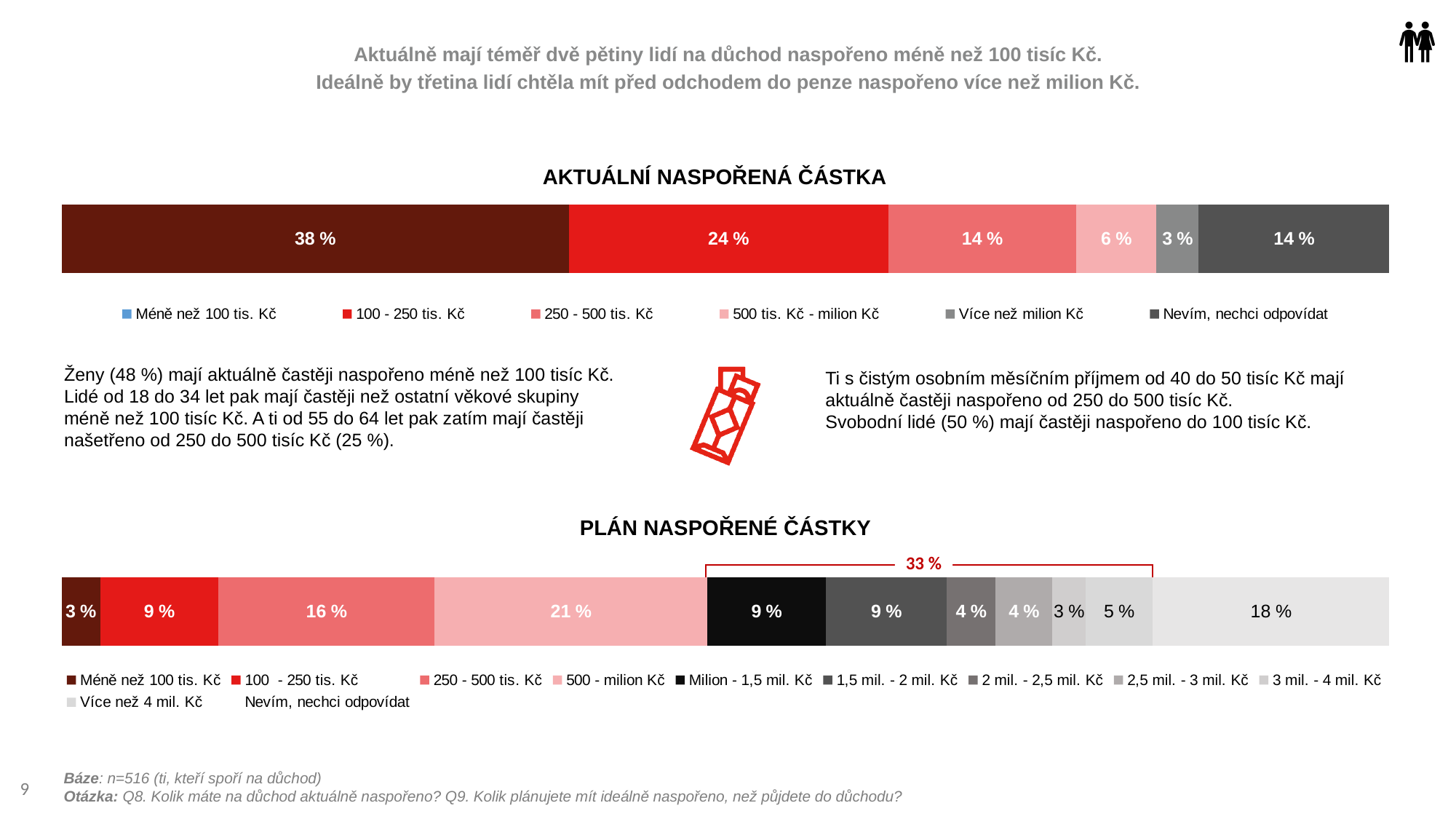
In the chart titled AKTUÁLNÍ NASPOŘENÁ ČÁSTKA, which category has the smallest share? Více než milion Kč In the chart titled PLÁN NASPOŘENÉ ČÁSTKY, how many categories does the legend list? 11 In the chart titled PLÁN NASPOŘENÉ ČÁSTKY, what is the value for 500 - milion Kč? 21 % In the chart titled AKTUÁLNÍ NASPOŘENÁ ČÁSTKA, what is the difference between the share for Méně než 100 tis. Kč and the share for 100 - 250 tis. Kč? 14 % In the chart titled AKTUÁLNÍ NASPOŘENÁ ČÁSTKA, what is the value for 100 - 250 tis. Kč? 24 % In the chart titled AKTUÁLNÍ NASPOŘENÁ ČÁSTKA, how many categories does the legend list? 6 In the chart titled PLÁN NASPOŘENÉ ČÁSTKY, what is the value for Nevím, nechci odpovídat? 18 % What type of chart is used for PLÁN NASPOŘENÉ ČÁSTKY? Stacked bar chart In the chart titled AKTUÁLNÍ NASPOŘENÁ ČÁSTKA, what share of people have saved less than 100 tis. Kč (Méně než 100 tis. Kč)? 38 % In the chart titled PLÁN NASPOŘENÉ ČÁSTKY, what combined share is marked by the red bracket above the bar? 33 % In the chart titled PLÁN NASPOŘENÉ ČÁSTKY, which is larger: the share for 250 - 500 tis. Kč or the share for Milion - 1,5 mil. Kč? 250 - 500 tis. Kč In the chart titled PLÁN NASPOŘENÉ ČÁSTKY, which category has the largest share? 500 - milion Kč